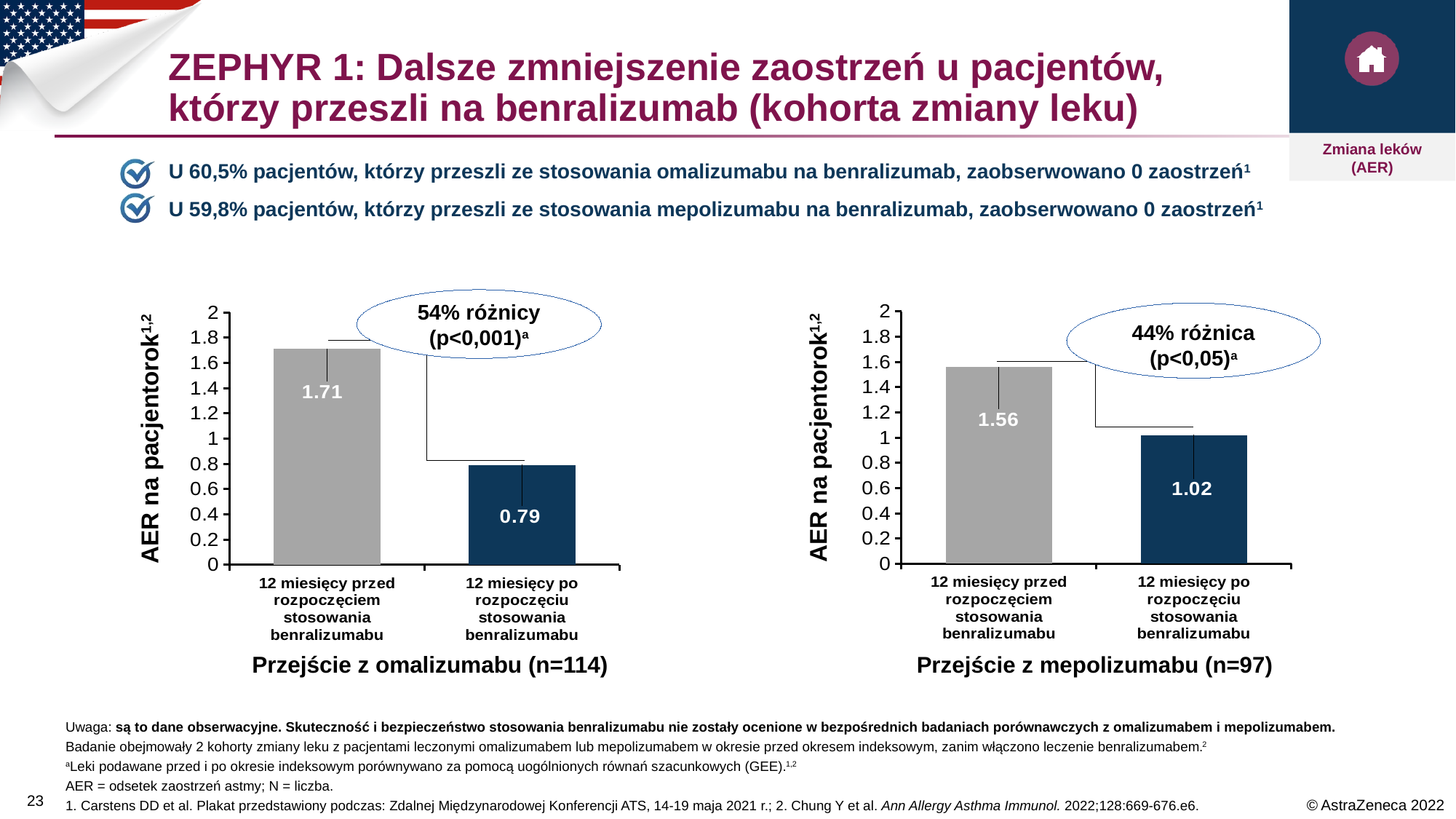
In the right chart (Przejście z mepolizumabu, n=97), what is the difference between the AER before and after starting benralizumab? 0.54 How many categories are shown in the left chart (Przejście z omalizumabu, n=114)? 2 In the right chart (Przejście z mepolizumabu, n=97), which category has the lower AER? 12 miesięcy po rozpoczęciu stosowania benralizumabu In the left chart (Przejście z omalizumabu, n=114), what is the difference between the AER before and after starting benralizumab? 0.92 In the right chart (Przejście z mepolizumabu, n=97), what is the AER value for '12 miesięcy przed rozpoczęciem stosowania benralizumabu'? 1.56 Is the AER after starting benralizumab larger in the left chart (omalizumab switch) or in the right chart (mepolizumab switch)? Right chart (mepolizumab switch) In the left chart (Przejście z omalizumabu, n=114), what is the AER value for '12 miesięcy po rozpoczęciu stosowania benralizumabu'? 0.79 In the right chart (Przejście z mepolizumabu, n=97), what is the AER value for '12 miesięcy po rozpoczęciu stosowania benralizumabu'? 1.02 In the left chart (Przejście z omalizumabu, n=114), what is the AER value for '12 miesięcy przed rozpoczęciem stosowania benralizumabu'? 1.71 What percentage difference is annotated on the right chart (Przejście z mepolizumabu, n=97)? 44% różnica (p<0,05) What type of chart is used on this slide? Bar chart In the left chart (Przejście z omalizumabu, n=114), which category has the higher AER? 12 miesięcy przed rozpoczęciem stosowania benralizumabu